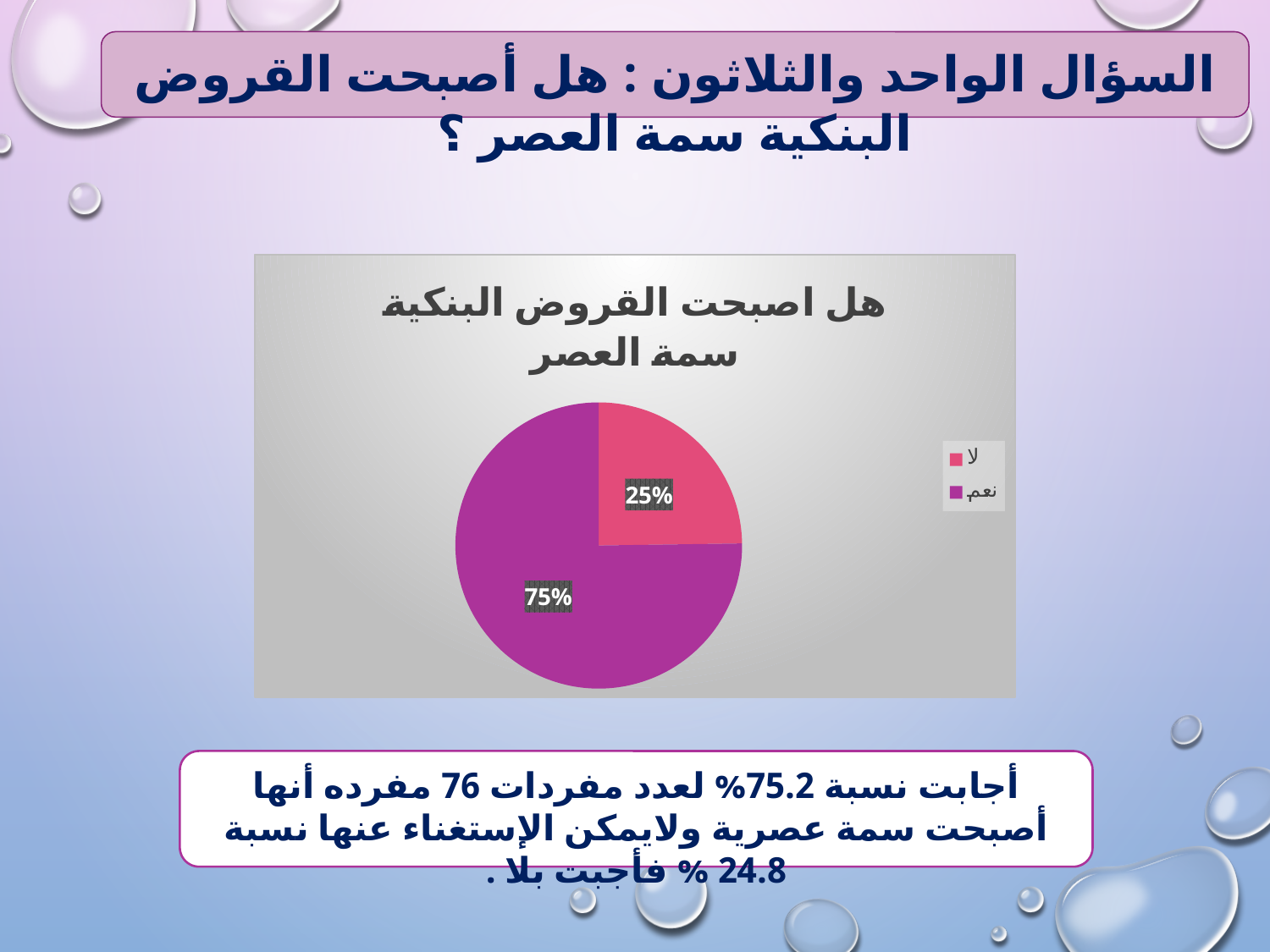
Which is larger, the "نعم" slice or the "لا" slice? نعم What is the title of the chart? هل اصبحت القروض البنكية سمة العصر What share of the pie does the "لا" slice represent? 25% What kind of chart is shown on the slide? pie chart What share of the pie does the "نعم" slice represent? 75% How many entries does the legend list? 2 What is the difference in percentage points between the "نعم" slice and the "لا" slice? 50% How many slices does the pie chart have? 2 Which slice is the smallest in the pie chart? لا What colour is the "لا" slice in the pie chart? pink Is the share for "نعم" greater or less than 50%? greater Which slice is the largest in the pie chart? نعم